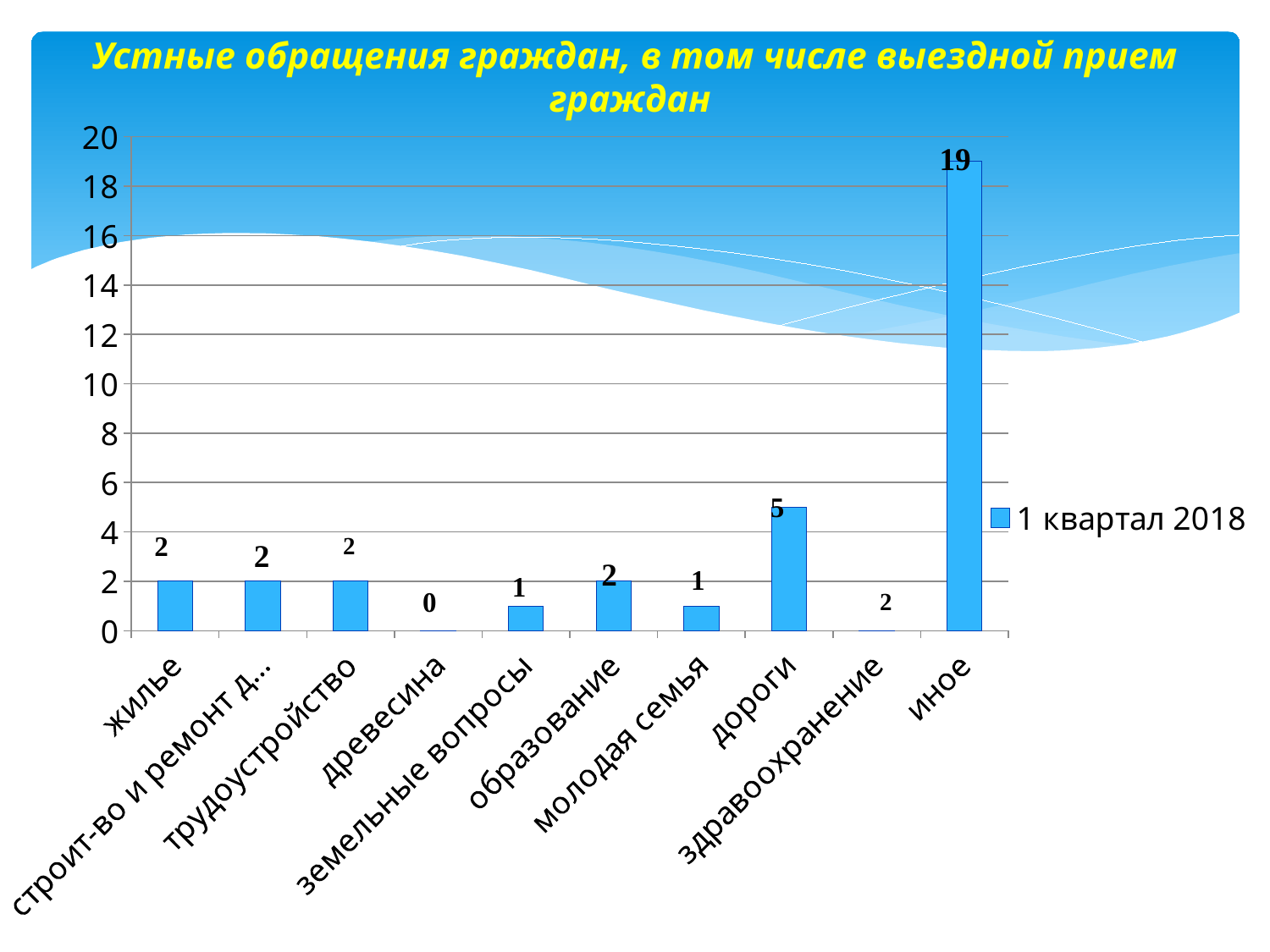
What is the value for земельные вопросы? 1 What is the value for иное? 19 What is the value for дороги? 5 Which category has the highest value? иное Is the value for дороги greater or less than 10? less What is the difference between the values for иное and дороги? 14 What is the value for жилье? 2 How many categories are shown on the x axis? 10 What is the value for древесина? 0 What kind of chart is shown on the slide? bar chart How many series does the legend list? 1 Which is larger, the value for дороги or the value for образование? дороги